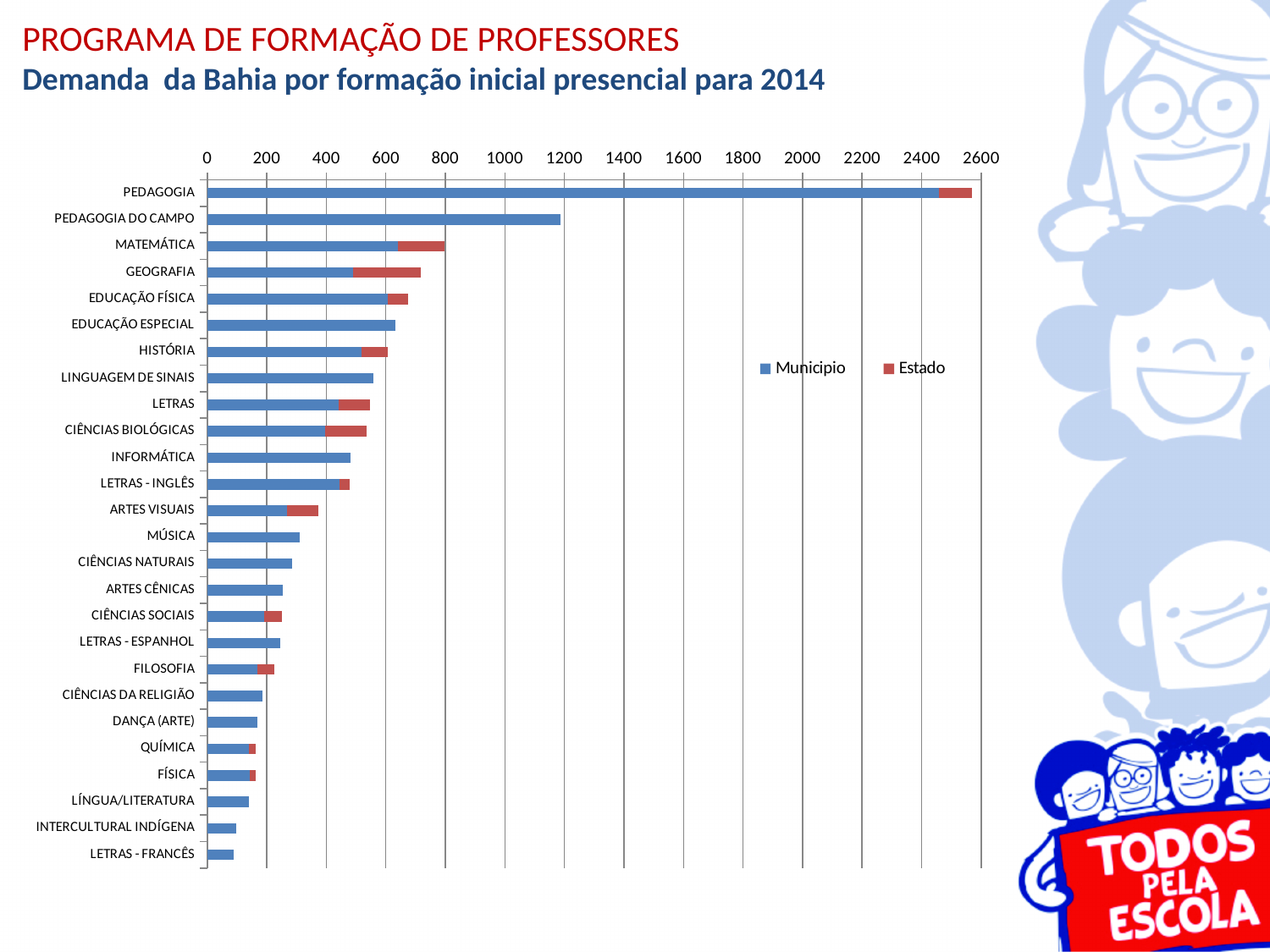
What are the two series named in the legend? Municipio and Estado Is the Municipio value for PEDAGOGIA DO CAMPO greater or less than 1000? greater Which category has the highest total demand? PEDAGOGIA Which has the larger Municipio value, MATEMÁTICA or GEOGRAFIA? MATEMÁTICA Which colour represents the Estado series in the chart? red How many categories (courses) are plotted on the chart? 26 Is the Municipio value for PEDAGOGIA greater or less than 2000? greater Is the Municipio value for GEOGRAFIA greater or less than 600? less What kind of chart is shown on the slide? bar chart How many series does the legend list? 2